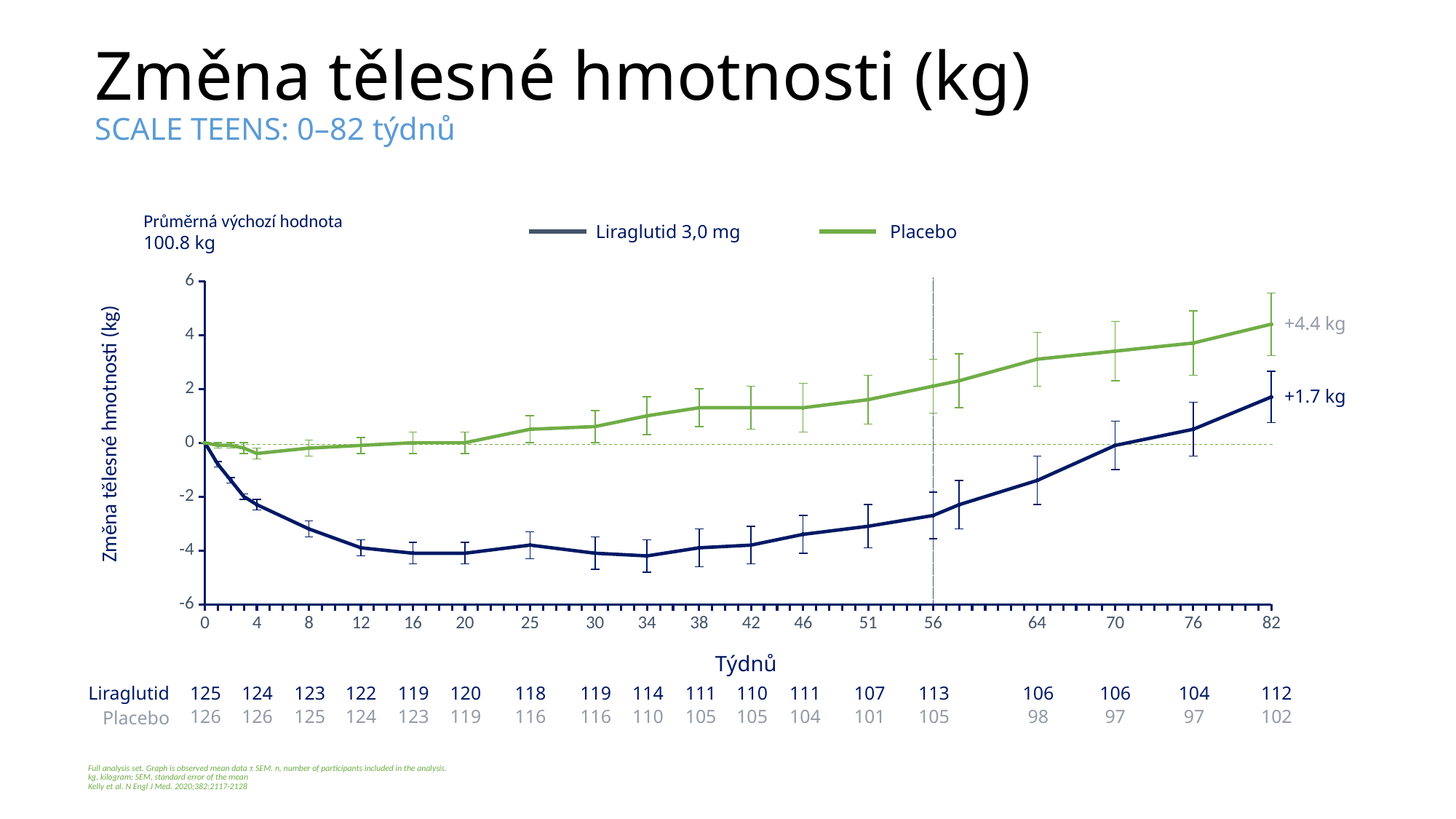
What is the change in body weight for Placebo at week 82? +4.4 kg What are the two legend entries of the chart? Liraglutid 3,0 mg and Placebo What is the mean baseline value (Průměrná výchozí hodnota) shown on the slide? 100.8 kg What is the difference between the Placebo and Liraglutid 3,0 mg values at week 82? 2.7 kg How many series does the legend list? 2 How many participants (n) are listed for Liraglutid at week 0? 125 Does the Placebo line rise or fall from week 0 to week 82? rise What is the change in body weight for Liraglutid 3,0 mg at week 82? +1.7 kg What kind of chart is shown on the slide? line chart Is the value for Placebo at week 64 greater or less than 2? greater Is the value for Liraglutid 3,0 mg at week 8 greater or less than -2? less At week 82, which series has the higher value, Placebo or Liraglutid 3,0 mg? Placebo